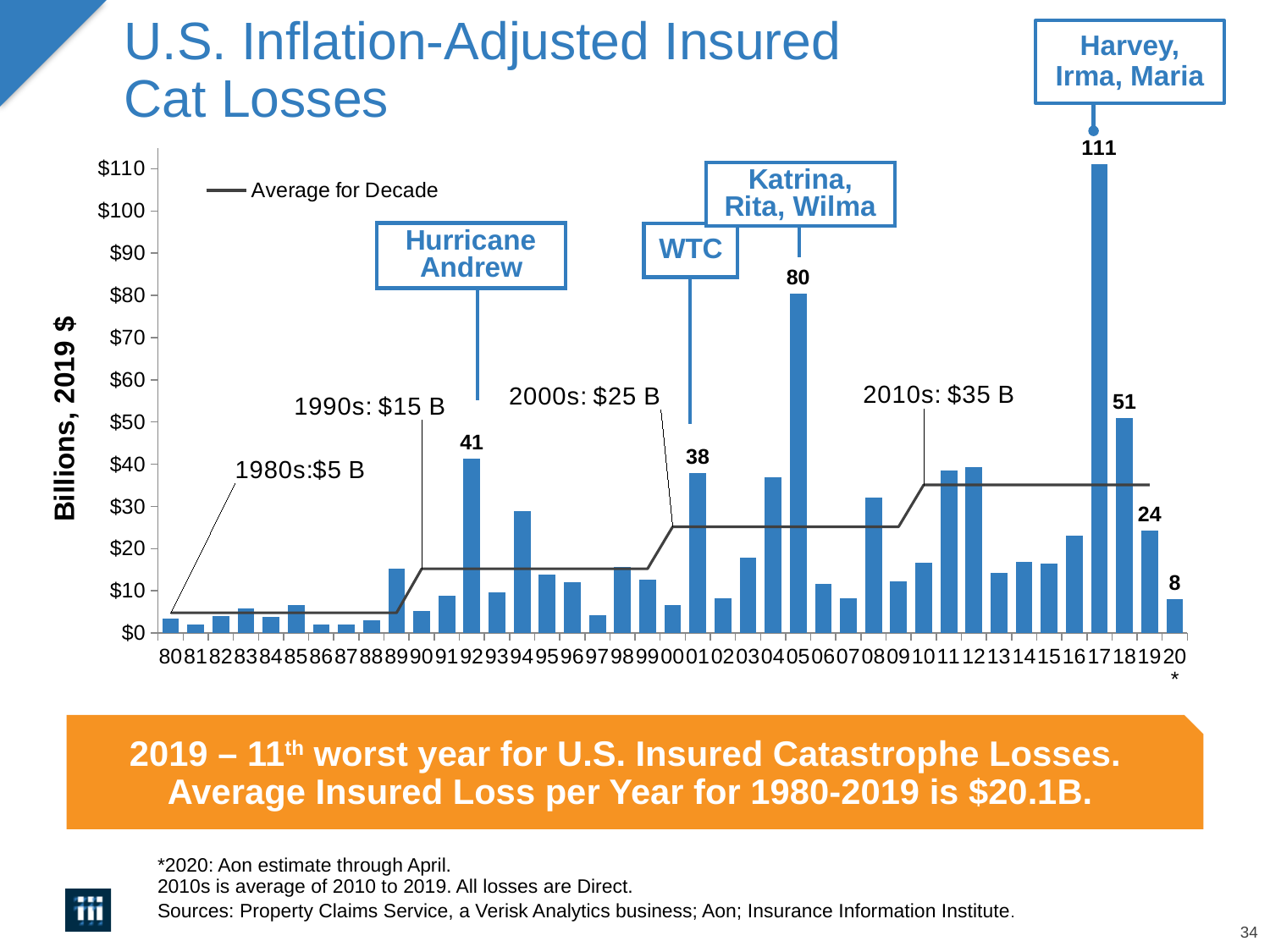
What is the average for the decade shown for the 2010s? $35 B What value is labeled on the bar for 2019? 24 Is the value for 2004 greater or less than $30? greater What kind of chart is used to show the insured cat losses? bar chart What is the difference between the labeled values for 2018 and 2019? 27 What value is labeled on the bar for 2005? 80 Is the value for 2010 greater or less than $20? less Which year has the larger labeled value, 1992 or 2001? 1992 What is the data label shown for 2017 in the U.S. Inflation-Adjusted Insured Cat Losses chart? 111 What does the legend say the black line represents? Average for Decade What is the difference between the labeled values for 2017 and 2005? 31 Which year has the highest insured cat losses in the chart? 2017